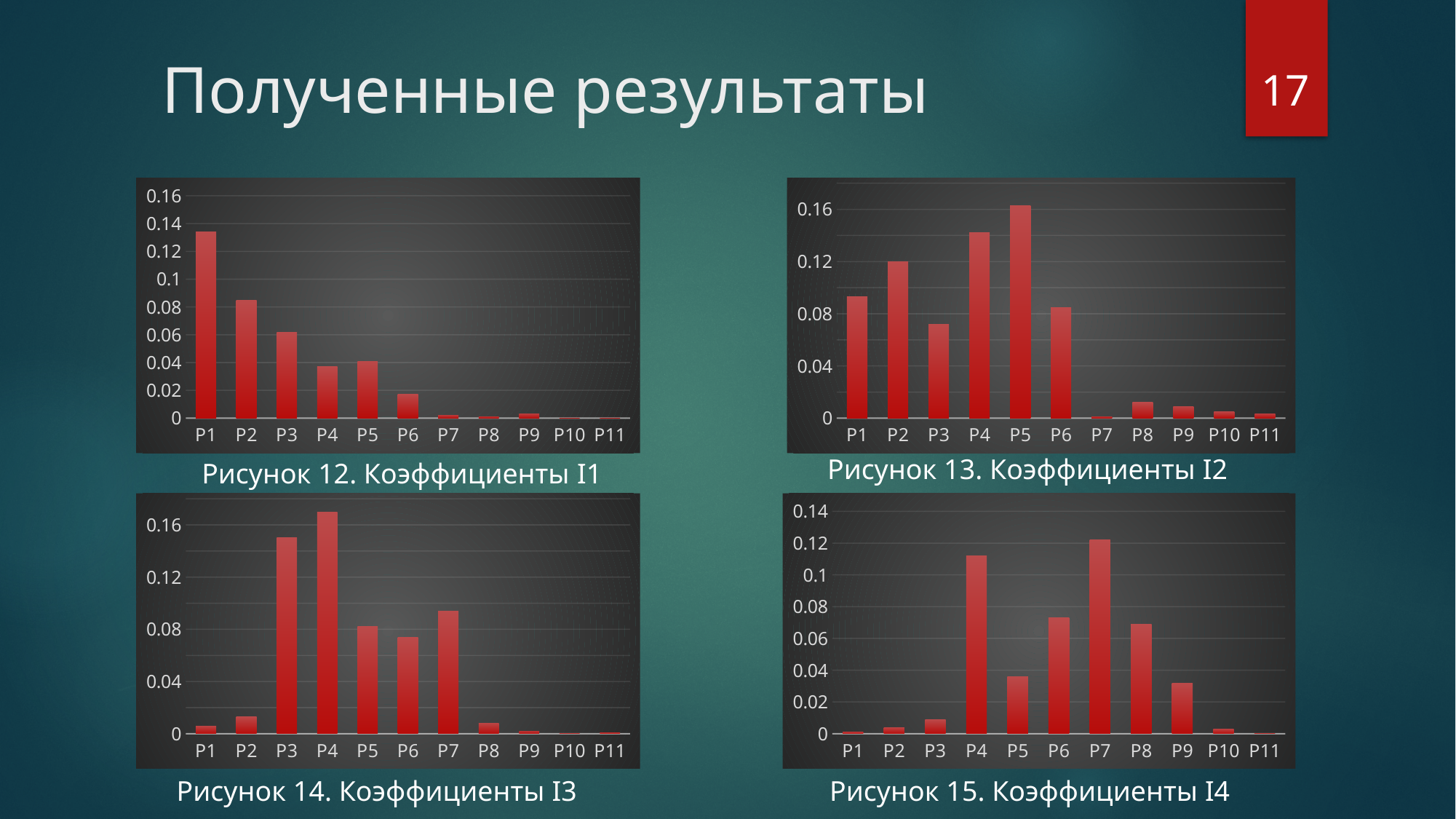
In Рисунок 14. Коэффициенты I3, which category has the highest value? P4 In Рисунок 15. Коэффициенты I4, which category has the highest value? P7 In Рисунок 12. Коэффициенты I1, do the values generally rise or fall from P1 to P11? fall What kind of chart is Рисунок 12. Коэффициенты I1? bar chart In Рисунок 13. Коэффициенты I2, which is larger, the value for P2 or the value for P3? P2 In Рисунок 13. Коэффициенты I2, is the value for P4 greater or less than 0.12? greater In Рисунок 15. Коэффициенты I4, which is larger, the value for P4 or the value for P7? P7 In Рисунок 15. Коэффициенты I4, is the value for P9 greater or less than 0.04? less How many categories are shown on the x axis of Рисунок 14. Коэффициенты I3? 11 In Рисунок 13. Коэффициенты I2, which category has the highest value? P5 In Рисунок 12. Коэффициенты I1, is the value for P1 greater or less than 0.12? greater